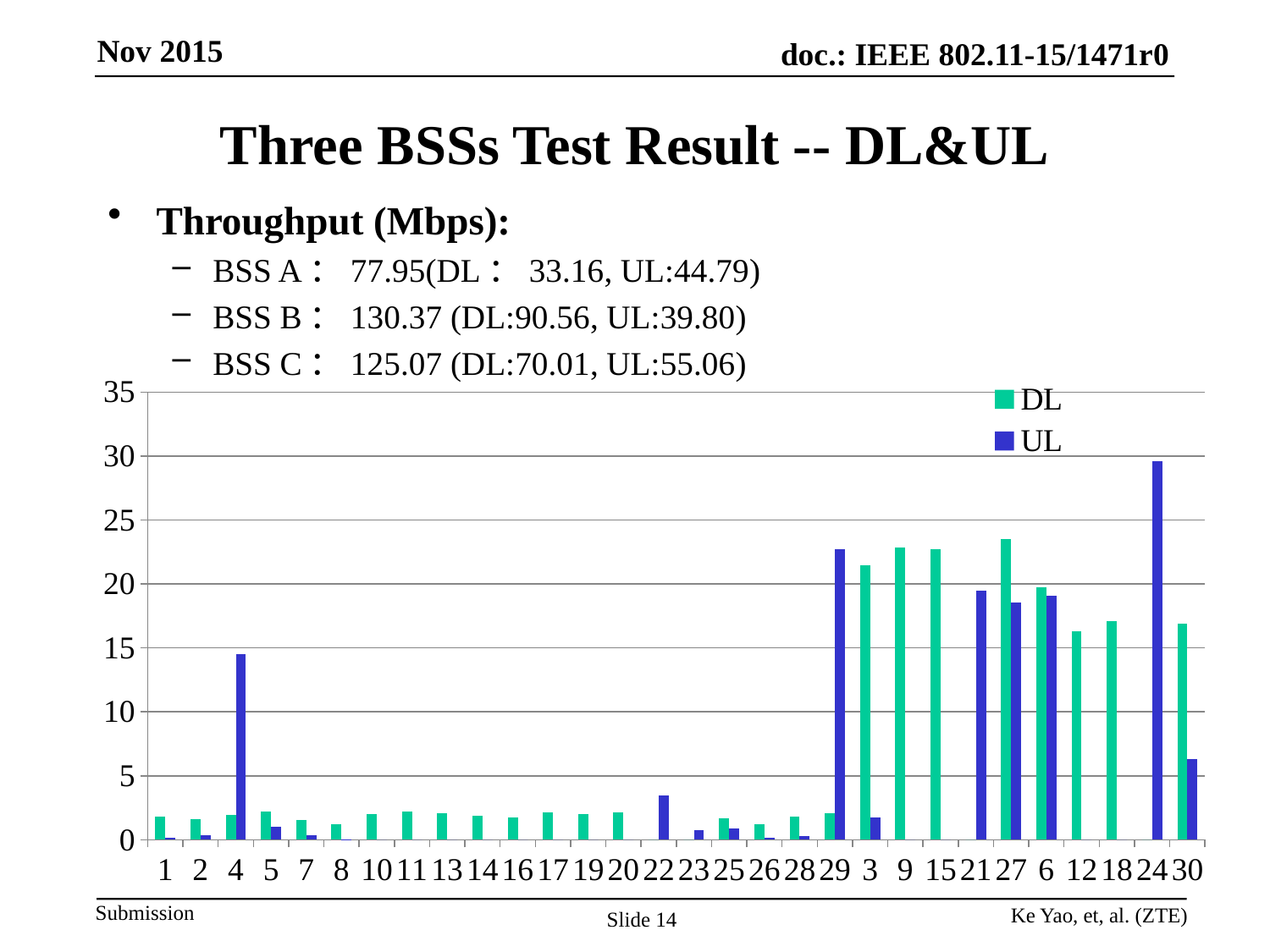
For category 4, which is larger, the DL value or the UL value? UL Which category has the highest UL value? 24 Is the UL value for category 24 greater or less than 25? greater For category 30, which is larger, the DL value or the UL value? DL Which colour represents the UL series in the chart? blue What kind of chart is shown on the slide? bar chart Is the DL value for category 3 greater or less than 20? greater How many series does the chart legend list? 2 Is the UL value for category 22 greater or less than 5? less How many categories are shown along the x axis of the chart? 30 What are the two series named in the chart legend? DL and UL